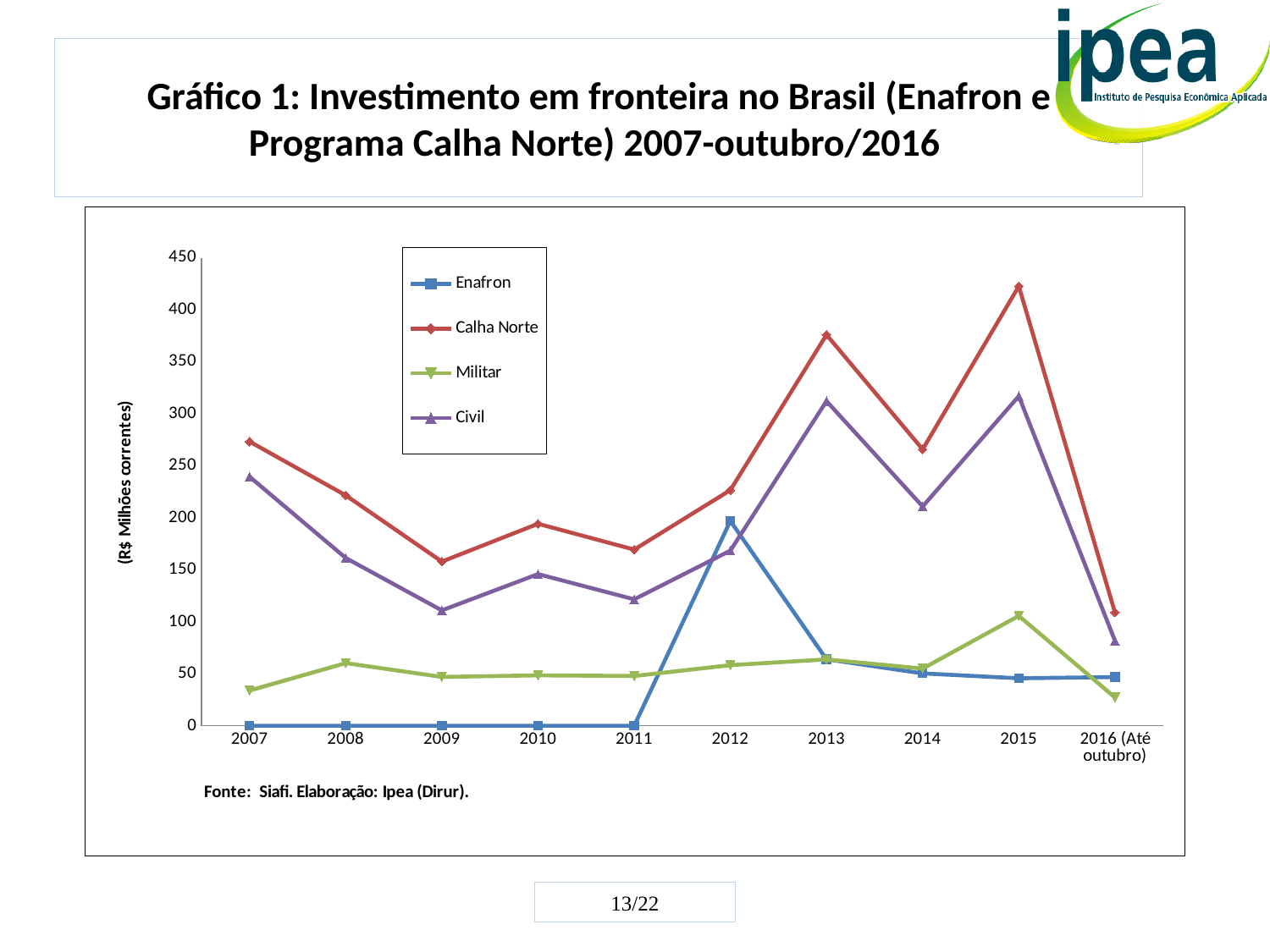
In which year does the Calha Norte series reach its highest value? 2015 Is the value for Calha Norte in 2015 greater or less than 400? greater Does the Calha Norte series rise or fall from 2007 to 2009? fall Is the value for Civil in 2007 greater or less than 200? greater How many points along the x axis does each series have? 10 In which period does the Calha Norte series reach its lowest value? 2016 (Até outubro) Which series has the larger value in 2013, Calha Norte or Civil? Calha Norte How many series does the legend list? 4 What kind of chart is shown on the slide? line chart In which year does the Enafron series reach its highest value? 2012 What is the value for Enafron in 2007? 0 Is the value for Enafron in 2012 greater or less than 150? greater